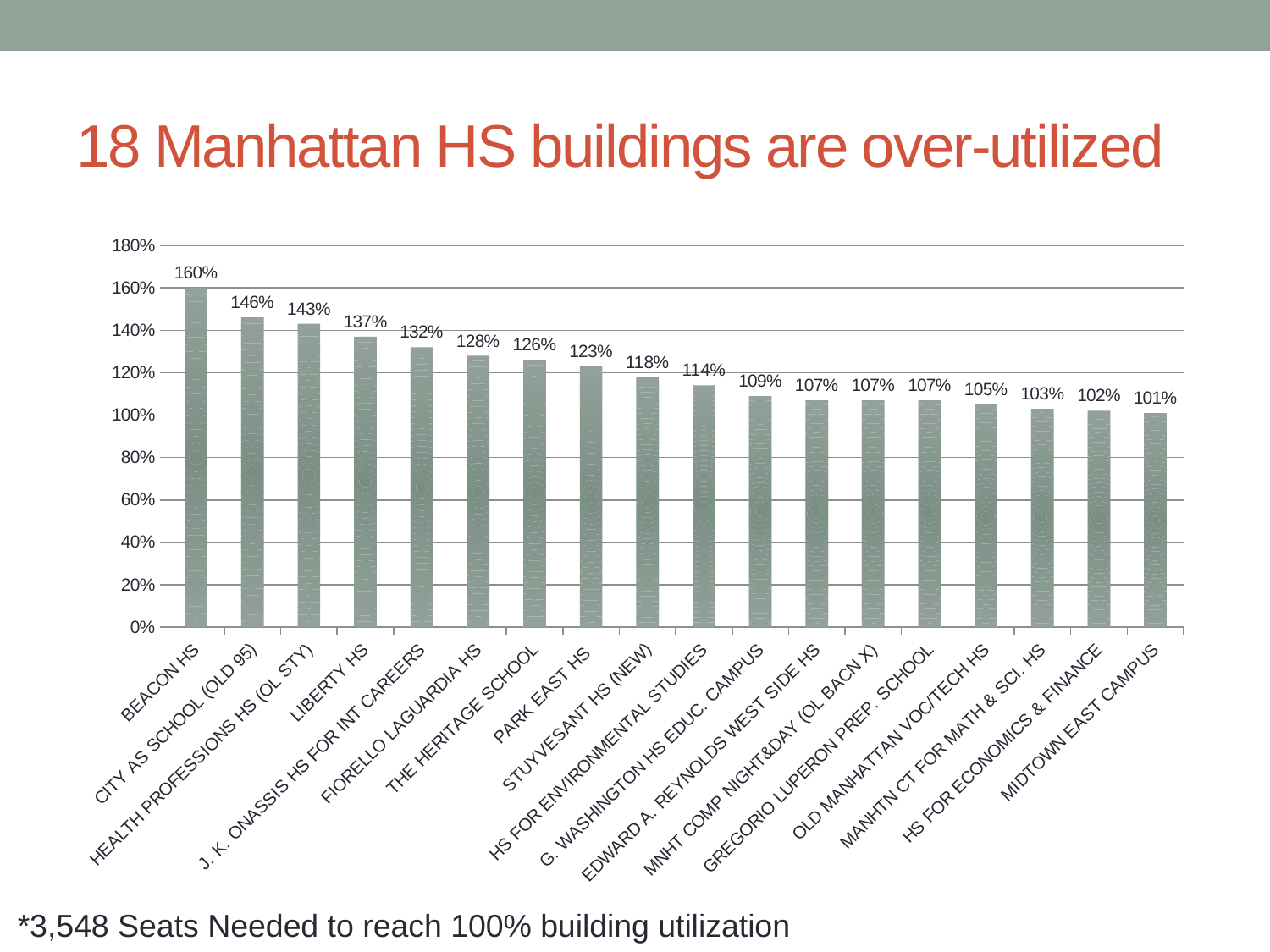
What is the difference between the utilization of LIBERTY HS and PARK EAST HS? 14% Do the values rise or fall moving from left to right along the x axis? Fall Which building has the lowest utilization in the chart? MIDTOWN EAST CAMPUS What type of chart is shown on the slide? Bar chart What is the utilization value shown for STUYVESANT HS (NEW)? 118% How many buildings are shown in the chart? 18 Is the value for HS FOR ENVIRONMENTAL STUDIES greater or less than 120%? less What is the difference between the utilization of BEACON HS and CITY AS SCHOOL (OLD 95)? 14% What is the utilization value shown for BEACON HS? 160% Which has a higher utilization, HEALTH PROFESSIONS HS (OL STY) or THE HERITAGE SCHOOL? HEALTH PROFESSIONS HS (OL STY) Which building has the highest utilization in the chart? BEACON HS What is the utilization value shown for FIORELLO LAGUARDIA HS? 128%